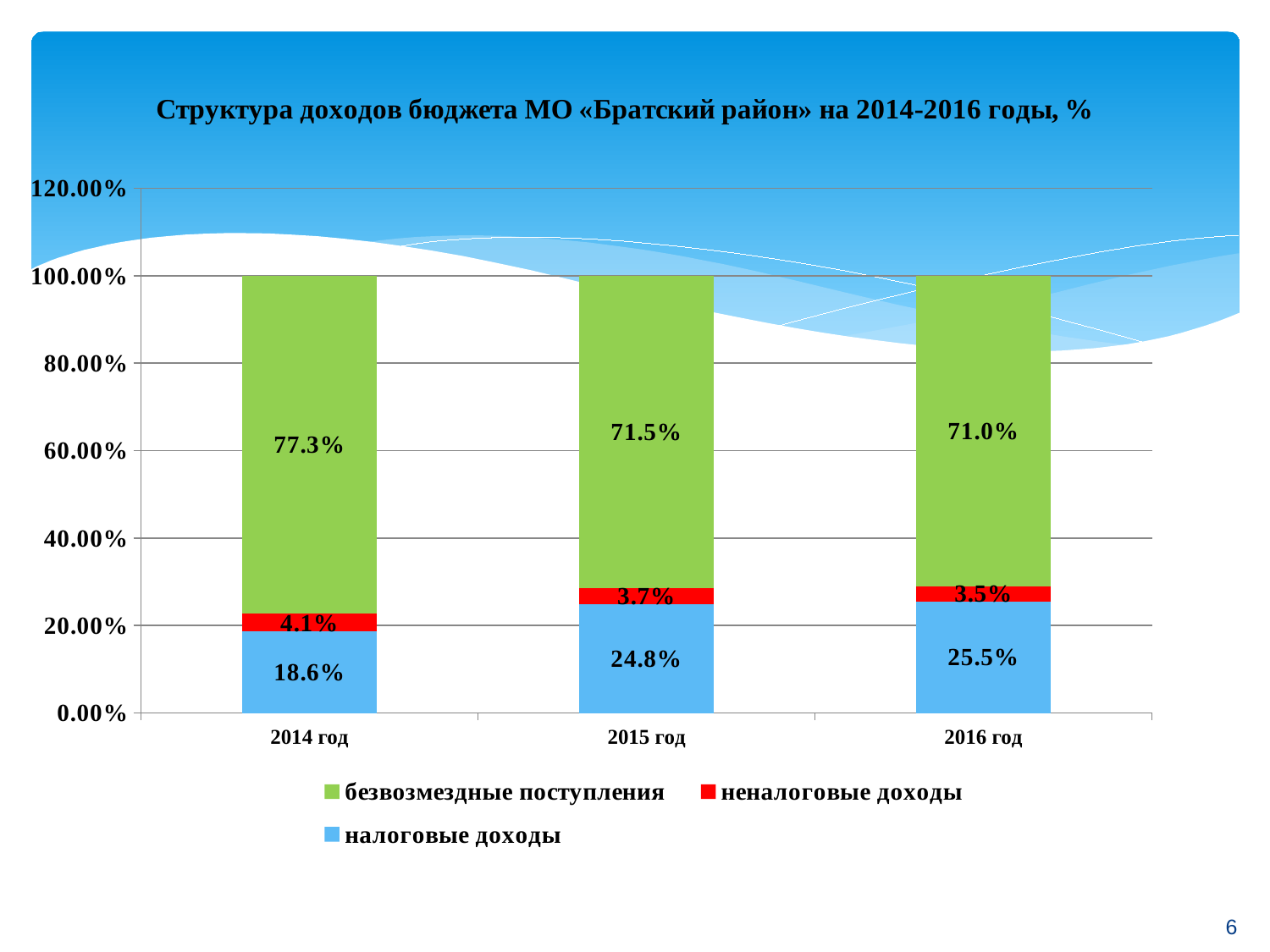
What is the difference between налоговые доходы in 2016 год and in 2014 год? 6.9% What kind of chart is shown on the slide? Stacked bar chart Which colour represents налоговые доходы in the chart? Blue How many years are shown on the x axis? 3 Which is larger: неналоговые доходы in 2014 год or in 2016 год? 2014 год In which year is the share of налоговые доходы lowest? 2014 год In which year is the share of безвозмездные поступления highest? 2014 год Does the share of безвозмездные поступления rise or fall from 2014 год to 2016 год? Fall What is the value for налоговые доходы in 2016 год? 25.5% What is the value for неналоговые доходы in 2015 год? 3.7% What is the value for безвозмездные поступления in 2014 год? 77.3% How many series does the legend list? 3